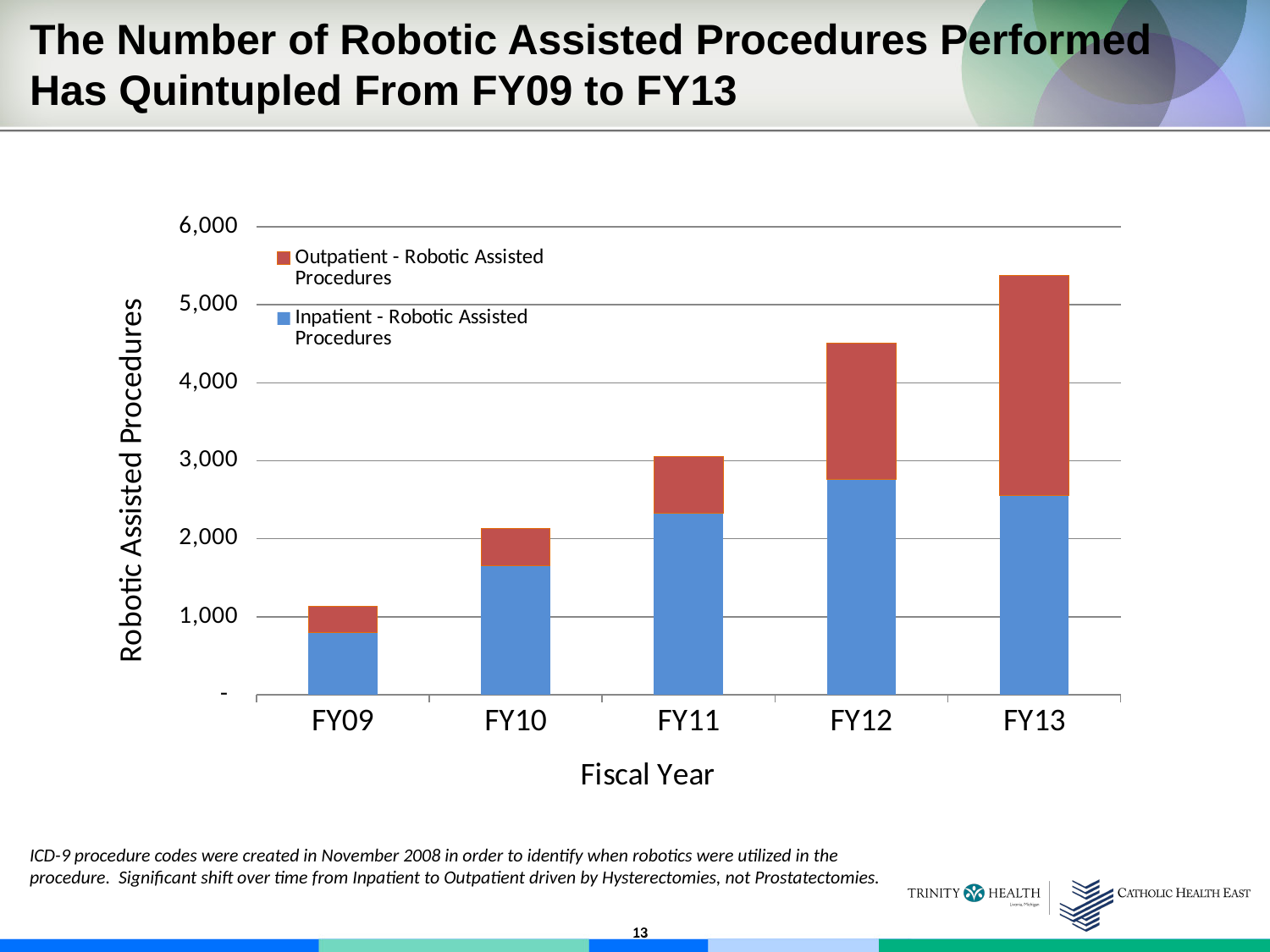
Is the total number of robotic assisted procedures for FY12 greater or less than 4,000? greater Which fiscal year has the lowest total number of robotic assisted procedures? FY09 Is the total number of robotic assisted procedures for FY10 greater or less than 3,000? less Do the total robotic assisted procedures rise or fall from FY09 to FY13? Rise How many fiscal years are shown on the x axis of the chart? 5 Which fiscal year has the highest total number of robotic assisted procedures? FY13 What kind of chart is shown on the slide? Stacked bar chart How many series does the chart's legend list? 2 Is the total number of robotic assisted procedures for FY09 greater or less than 2,000? less Which fiscal year has a larger total of robotic assisted procedures, FY11 or FY12? FY12 What is the title of the chart's y axis? Robotic Assisted Procedures